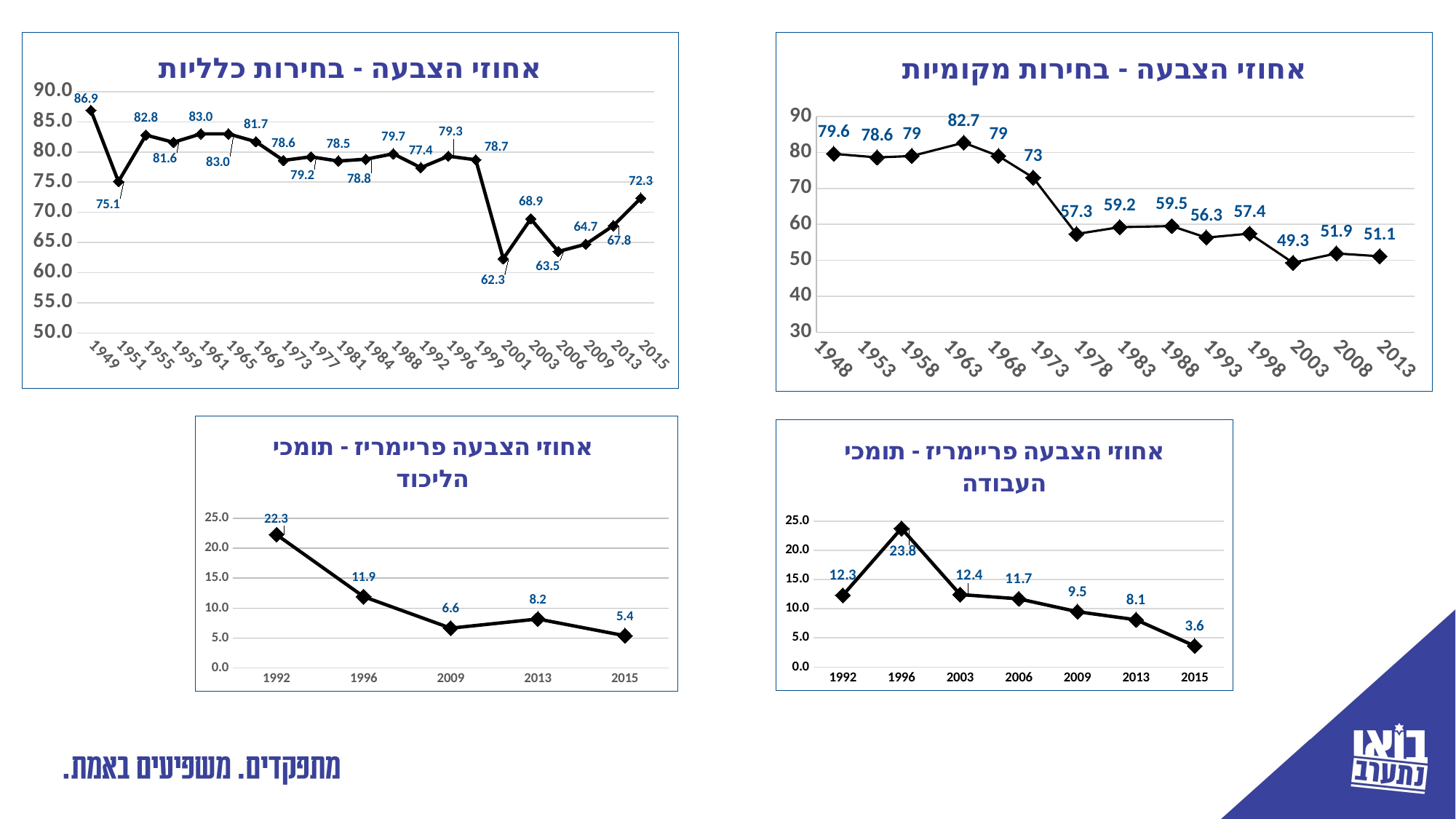
What kind of chart is the top-right chart (אחוזי הצבעה - בחירות מקומיות)? line chart In the top-right chart (אחוזי הצבעה - בחירות מקומיות), what is the value for 1963? 82.7 In the bottom-left chart (אחוזי הצבעה פריימריז - תומכי הליכוד), what is the value for 1996? 11.9 In the top-right chart (אחוזי הצבעה - בחירות מקומיות), which year has the lowest value? 2003 How many data points are plotted in the top-left chart (אחוזי הצבעה - בחירות כלליות)? 21 In the top-left chart (אחוזי הצבעה - בחירות כלליות), what is the difference between the values for 2015 and 2013? 4.5 In the bottom-left chart (אחוזי הצבעה פריימריז - תומכי הליכוד), which is larger, the value for 2009 or the value for 2013? 2013 In the bottom-right chart (אחוזי הצבעה פריימריז - תומכי העבודה), do the values rise or fall from 1996 to 2015? fall In the top-right chart (אחוזי הצבעה - בחירות מקומיות), is the value for 1978 greater or less than 60? less In the bottom-right chart (אחוזי הצבעה פריימריז - תומכי העבודה), which year has the highest value? 1996 In the top-left chart (אחוזי הצבעה - בחירות כלליות), which year has the lowest value? 2001 In the top-left chart (אחוזי הצבעה - בחירות כלליות), what is the value for 1949? 86.9